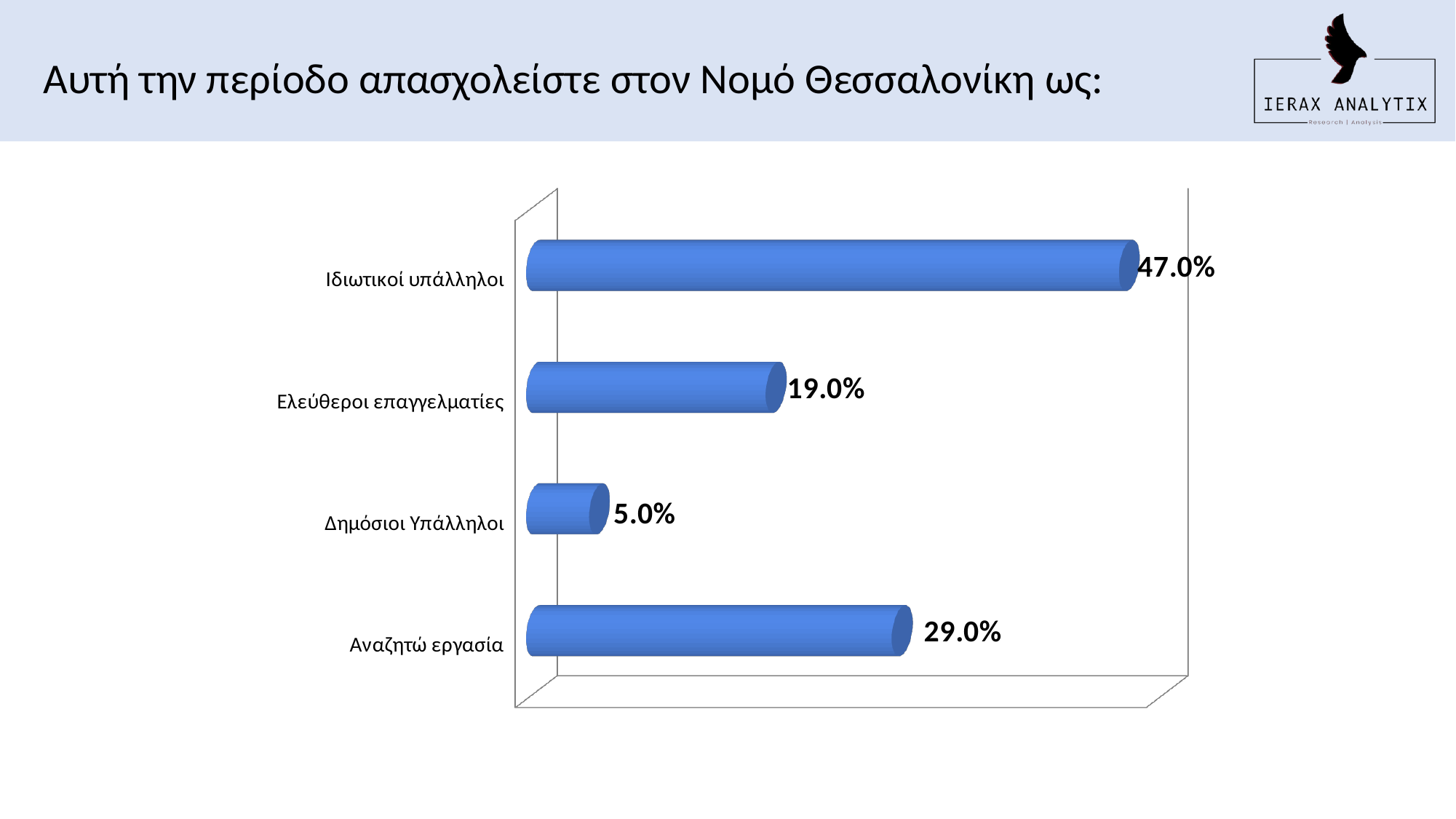
Which category has the highest value? Ιδιωτικοί υπάλληλοι What kind of chart is shown on the slide? Bar chart What is the value for Αναζητώ εργασία? 29.0% How many categories are shown in the chart? 4 What is the value for Δημόσιοι Υπάλληλοι? 5.0% Which is larger: the value for Αναζητώ εργασία or the value for Ελεύθεροι επαγγελματίες? Αναζητώ εργασία What is the value for Ιδιωτικοί υπάλληλοι? 47.0% What is the difference between the values for Ελεύθεροι επαγγελματίες and Δημόσιοι Υπάλληλοι? 14.0% What is the title of the slide? Αυτή την περίοδο απασχολείστε στον Νομό Θεσσαλονίκη ως: What is the difference between the values for Ιδιωτικοί υπάλληλοι and Αναζητώ εργασία? 18.0% What is the value for Ελεύθεροι επαγγελματίες? 19.0% Which category has the lowest value? Δημόσιοι Υπάλληλοι